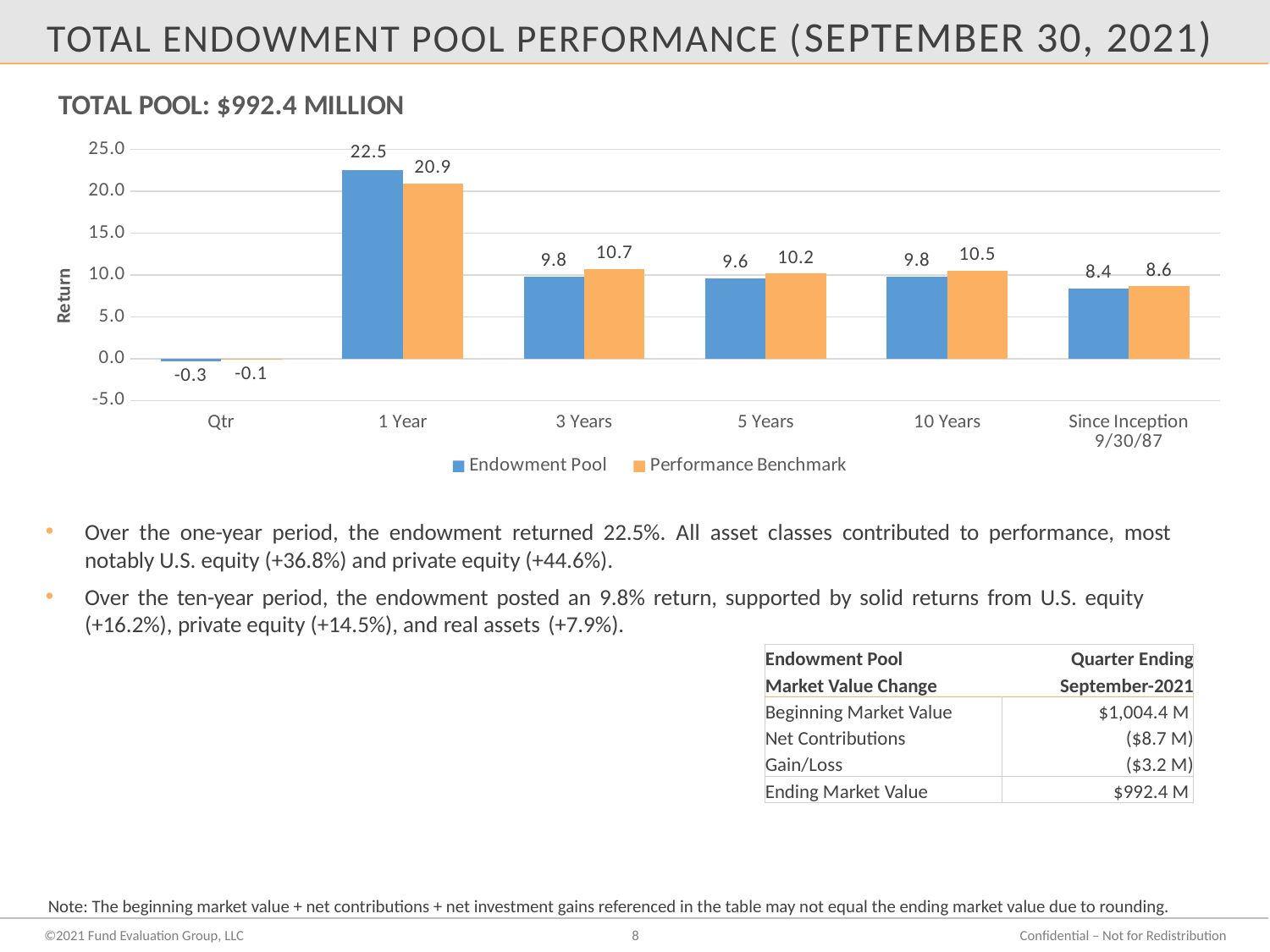
What is the label of the y axis of the chart? Return How many periods are shown on the x axis of the chart? 6 What is the Endowment Pool return for the 1 Year period? 22.5 What kind of chart is shown on the slide? Bar chart What is the Endowment Pool return for the Since Inception 9/30/87 period? 8.4 Which period has the lowest Performance Benchmark return? Qtr Which period has the highest Endowment Pool return? 1 Year What is the Performance Benchmark return for the 5 Years period? 10.2 What is the difference between the Performance Benchmark and Endowment Pool returns for the 10 Years period? 0.7 For the 3 Years period, which is larger: the Endowment Pool return or the Performance Benchmark return? Performance Benchmark What is the Endowment Pool return for the Qtr period? -0.3 How many series does the chart legend list? 2